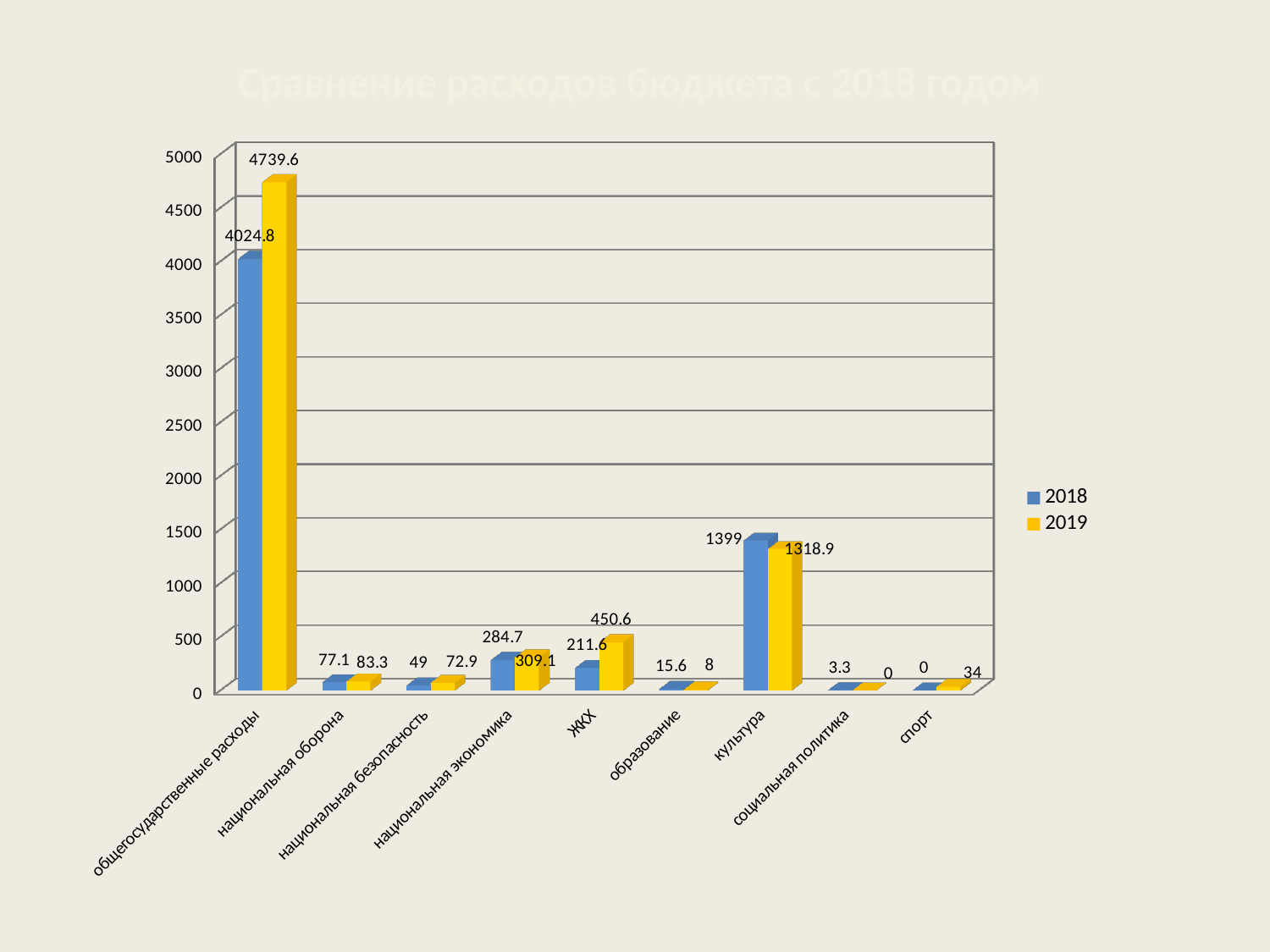
Is the 2019 value for ЖКХ greater or less than 500? less How many categories are shown on the x axis? 9 What kind of chart is shown on the slide? bar chart Which is larger for культура: the 2018 value or the 2019 value? 2018 What is the difference between the 2019 and 2018 values for общегосударственные расходы? 714.8 Which category has the highest 2019 value? общегосударственные расходы Which category has the lowest 2018 value? спорт What is the 2018 value for культура? 1399 What is the 2018 value for ЖКХ? 211.6 What is the 2019 value for общегосударственные расходы? 4739.6 What is the 2019 value for спорт? 34 How many series does the legend list? 2